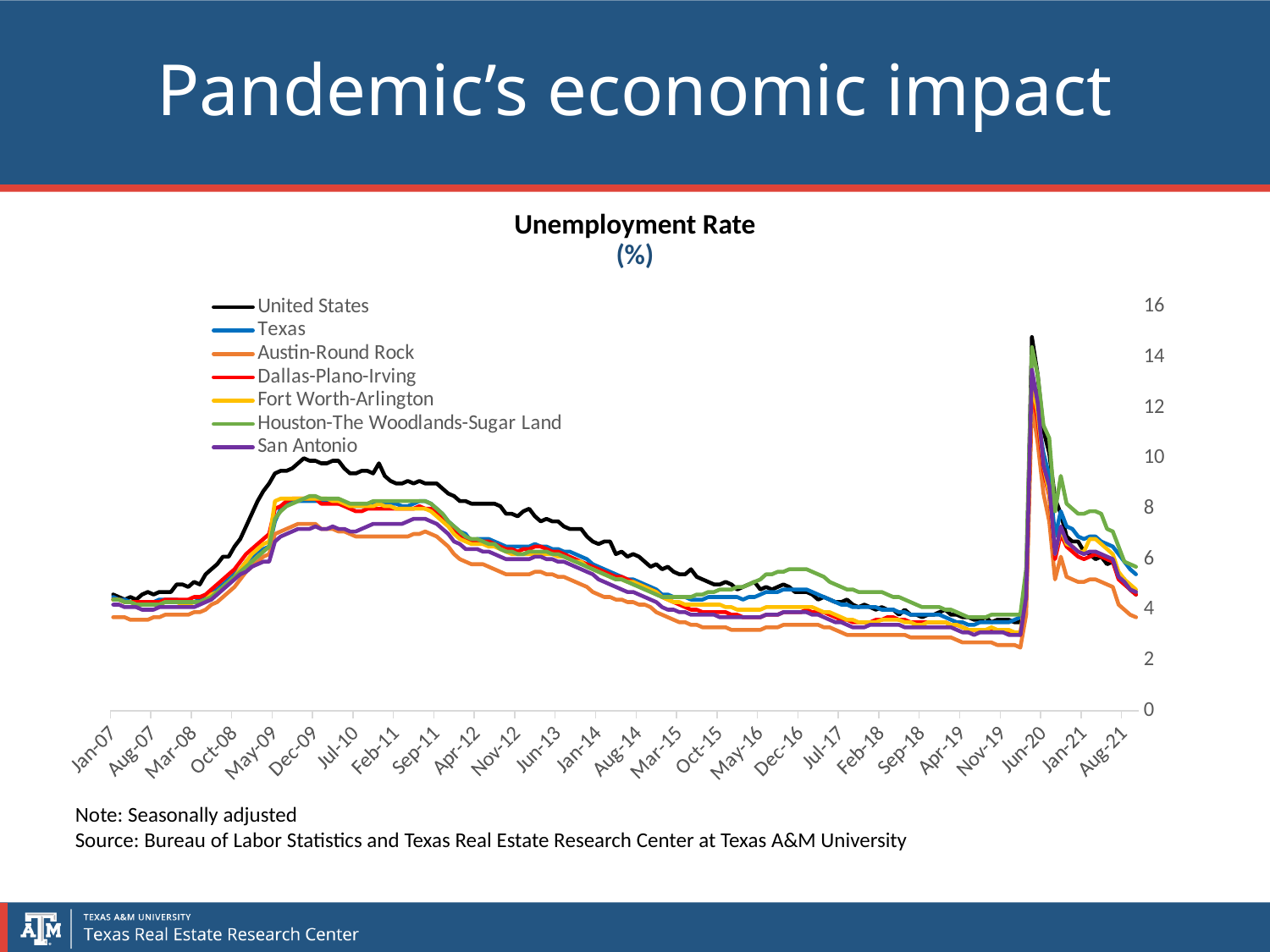
Is the value for the United States around Dec-09 greater or less than 8? greater What is the title of the chart? Unemployment Rate (%) Which series reaches the highest unemployment rate at the 2020 spike? United States Is the value for Houston-The Woodlands-Sugar Land around Jan-21 greater or less than 6? greater Is the peak value for the United States in 2020 greater or less than 14? greater Does the United States unemployment rate rise or fall between Dec-09 and Nov-19? fall Does the United States unemployment rate rise or fall between Jan-07 and Dec-09? rise Which colour is used for the United States line? black Which series has the lowest unemployment rate in the period just before the 2020 spike (around Nov-19)? Austin-Round Rock How many series does the legend list? 7 What kind of chart is shown on the slide? line chart